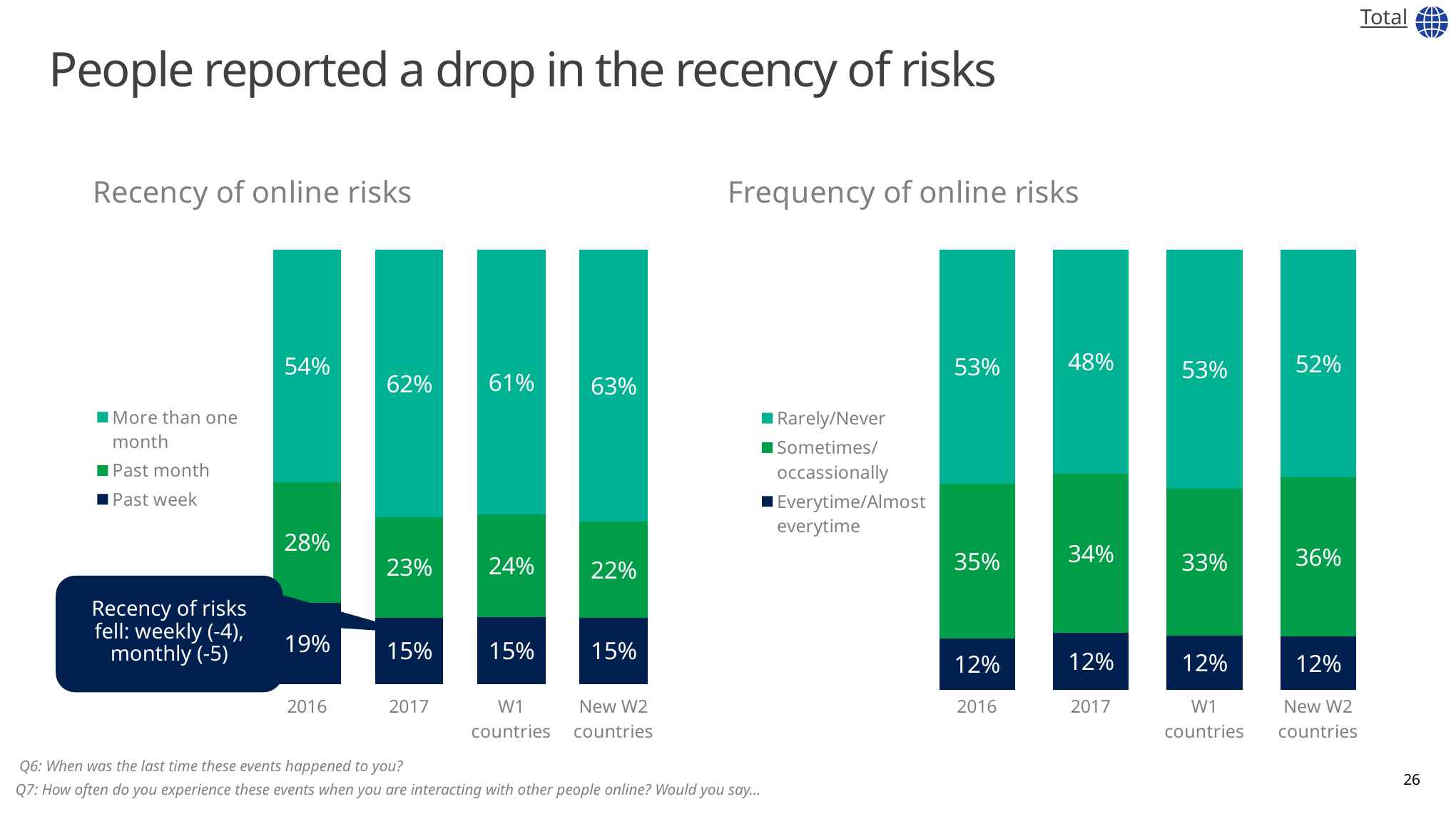
In the 'Frequency of online risks' chart, what is the value for 'Rarely/Never' for W1 countries? 53% In the 'Recency of online risks' chart, which category has the highest 'Past month' value? 2016 In the 'Recency of online risks' chart, what is the value for 'Past week' in 2016? 19% What kind of chart is the 'Recency of online risks' chart? Stacked bar chart How many categories are shown on the x axis of the 'Recency of online risks' chart? 4 In the 'Frequency of online risks' chart, which category has the lowest 'Rarely/Never' value? 2017 In the 'Recency of online risks' chart, what is the difference between the 'Past week' values for 2016 and 2017? 4 percentage points In the 'Recency of online risks' chart, what is the total of the stacked bar for 2017? 100% In the 'Recency of online risks' chart, what is the value for 'More than one month' for New W2 countries? 63% In the 'Frequency of online risks' chart, what is the value for 'Sometimes/occassionally' in 2017? 34% How many series does the legend of the 'Frequency of online risks' chart list? 3 In the 'Frequency of online risks' chart, is the 'Sometimes/occassionally' value larger for New W2 countries or for W1 countries? New W2 countries